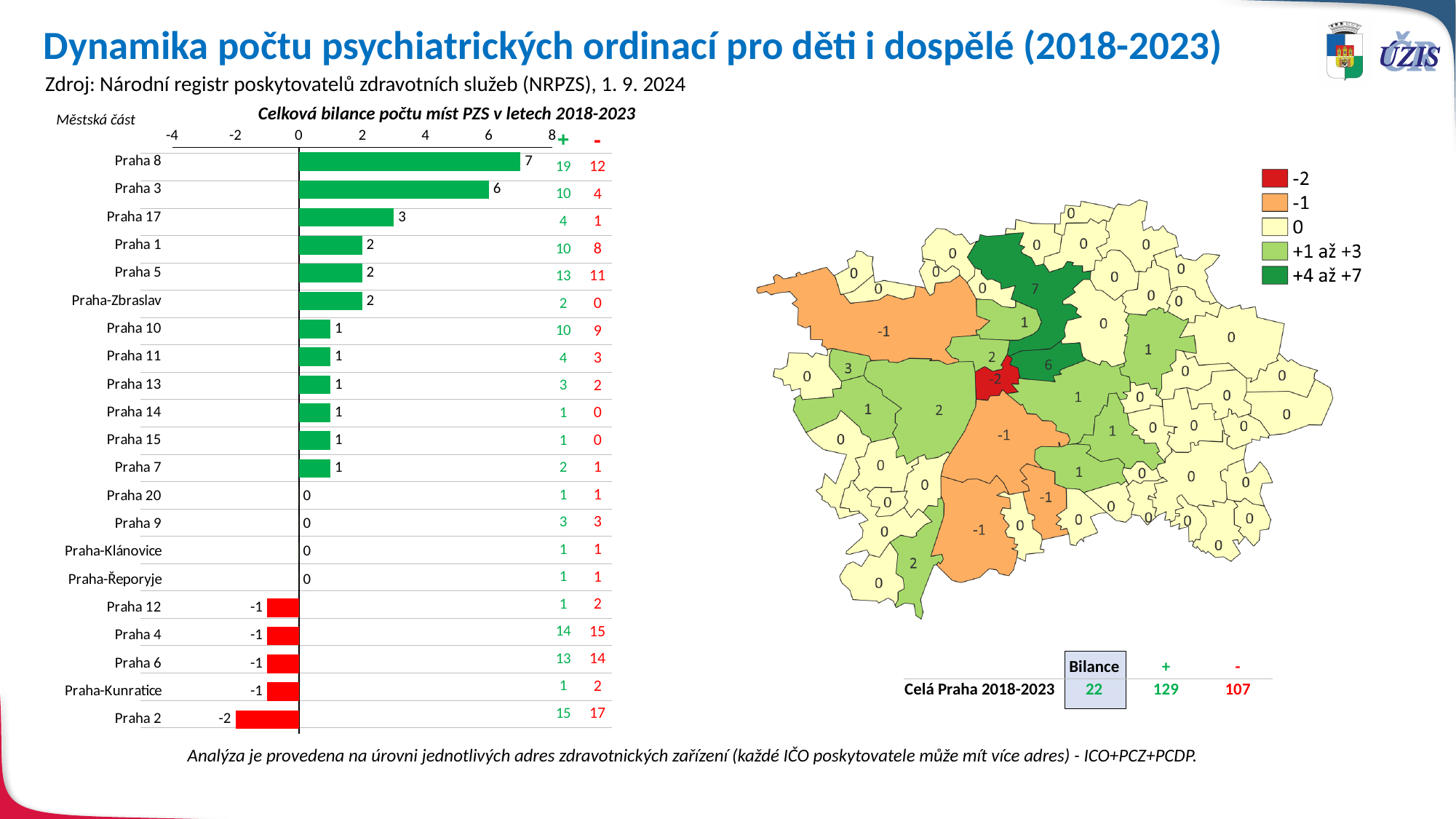
What is the title of the bar chart? Celková bilance počtu míst PZS v letech 2018-2023 What kind of chart is used to show the balance of PZS places by city district? Bar chart What is the difference between the values for Praha 8 and Praha 3 in the bar chart? 1 What is the value for Praha-Zbraslav in the bar chart? 2 What is the value for Praha 17 in the bar chart? 3 What is the value for Praha 8 in the bar chart? 7 How many city districts are shown in the bar chart? 21 Which city district has the lowest value in the bar chart? Praha 2 What is the value for Praha 2 in the bar chart? -2 Which has a larger value in the bar chart, Praha 3 or Praha 1? Praha 3 Which city district has the highest value in the bar chart? Praha 8 What is the difference between the values for Praha 17 and Praha 2 in the bar chart? 5